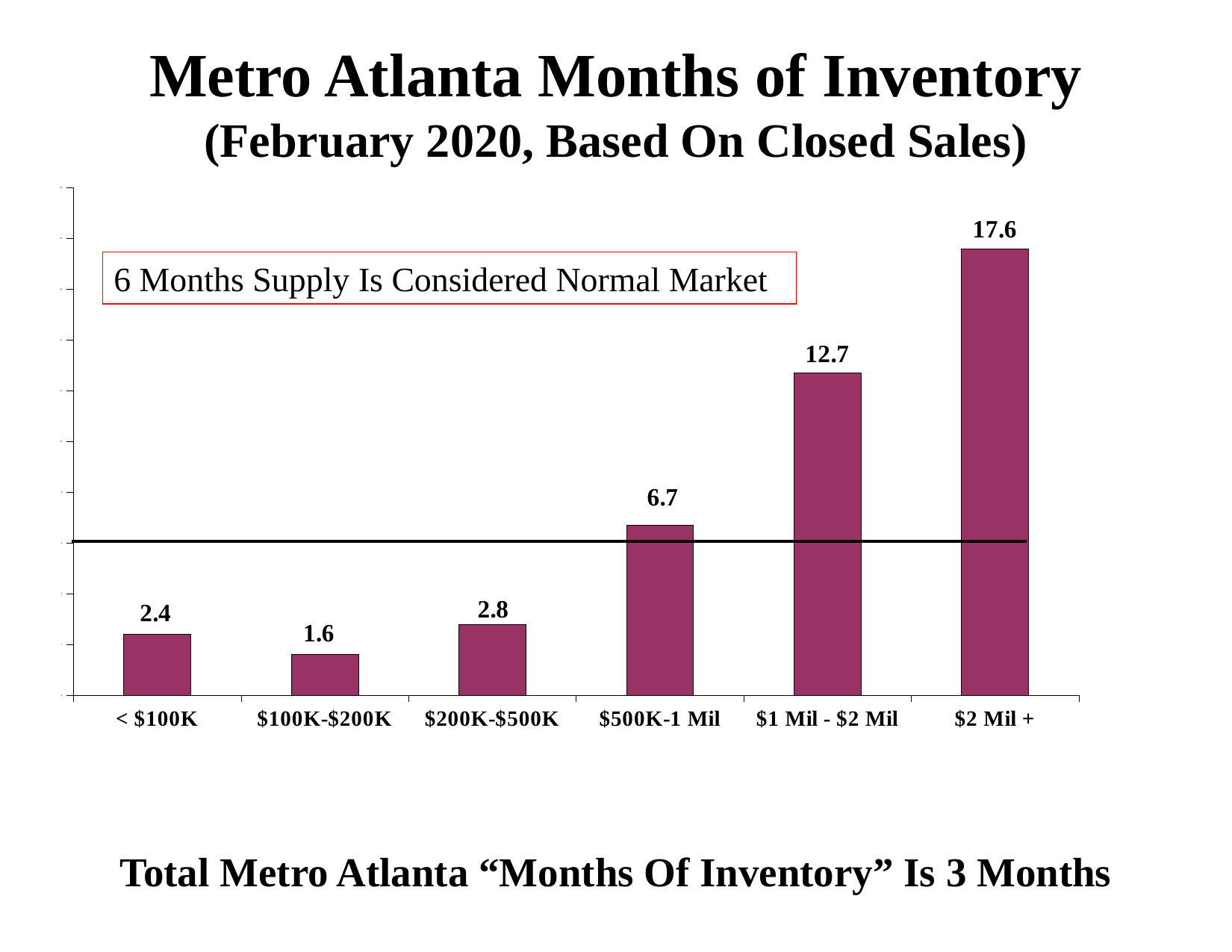
What is the months of inventory value for the $2 Mil + price range? 17.6 Which price range has the lowest months of inventory? $100K-$200K What is the months of inventory value for the $100K-$200K price range? 1.6 What is the months of inventory value for the $500K-1 Mil price range? 6.7 According to the text box on the chart, how many months of supply is considered a normal market? 6 Months Which price range has the highest months of inventory? $2 Mil + Which has a higher months of inventory value, < $100K or $200K-$500K? $200K-$500K What kind of chart is shown on the slide? Bar chart What is the difference in months of inventory between the $200K-$500K and < $100K price ranges? 0.4 What is the difference in months of inventory between the $2 Mil + and $1 Mil - $2 Mil price ranges? 4.9 How many price range categories are shown on the chart? 6 Do the months of inventory values generally rise or fall as the price range increases from $100K-$200K to $2 Mil +? Rise